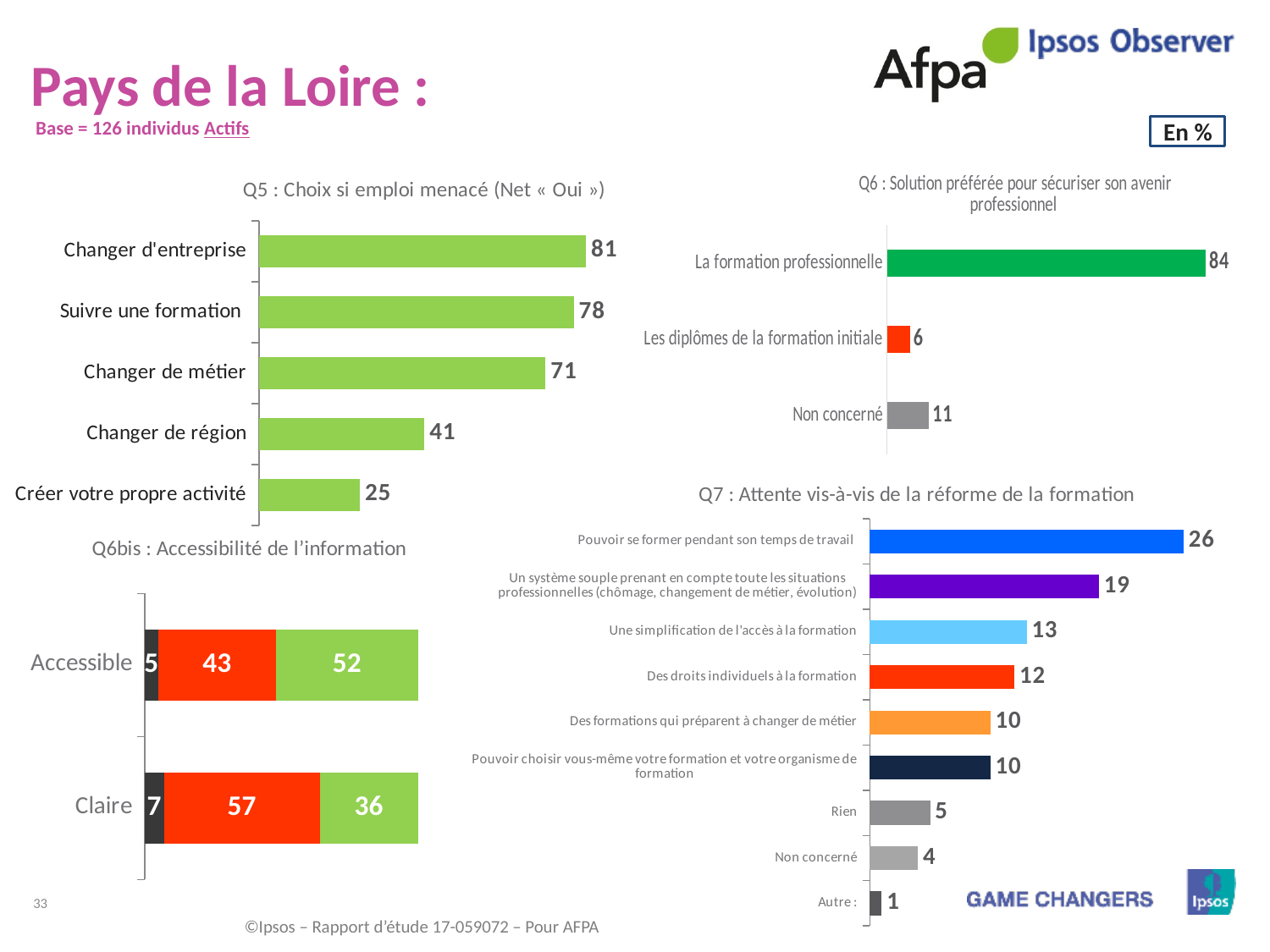
In the Q5 chart (Choix si emploi menacé), what is the value for Changer de région? 41 What kind of chart is the Q7 chart (Attente vis-à-vis de la réforme de la formation)? bar chart In the Q7 chart (Attente vis-à-vis de la réforme de la formation), what is the value for Une simplification de l'accès à la formation? 13 In the Q6bis chart (Accessibilité de l'information), what is the value of the green segment for Accessible? 52 In the Q5 chart (Choix si emploi menacé), what is the difference between Suivre une formation and Changer de métier? 7 In the Q5 chart (Choix si emploi menacé), which category has the highest value? Changer d'entreprise In the Q6 chart (Solution préférée pour sécuriser son avenir professionnel), which is larger: Les diplômes de la formation initiale or Non concerné? Non concerné In the Q7 chart (Attente vis-à-vis de la réforme de la formation), which category has the highest value? Pouvoir se former pendant son temps de travail In the Q5 chart (Choix si emploi menacé), which category has the lowest value? Créer votre propre activité In the Q6bis chart (Accessibilité de l'information), what is the total of the stacked bar for Claire? 100 In the Q6 chart (Solution préférée pour sécuriser son avenir professionnel), what is the value for La formation professionnelle? 84 In the Q5 chart (Choix si emploi menacé), how many categories are shown? 5